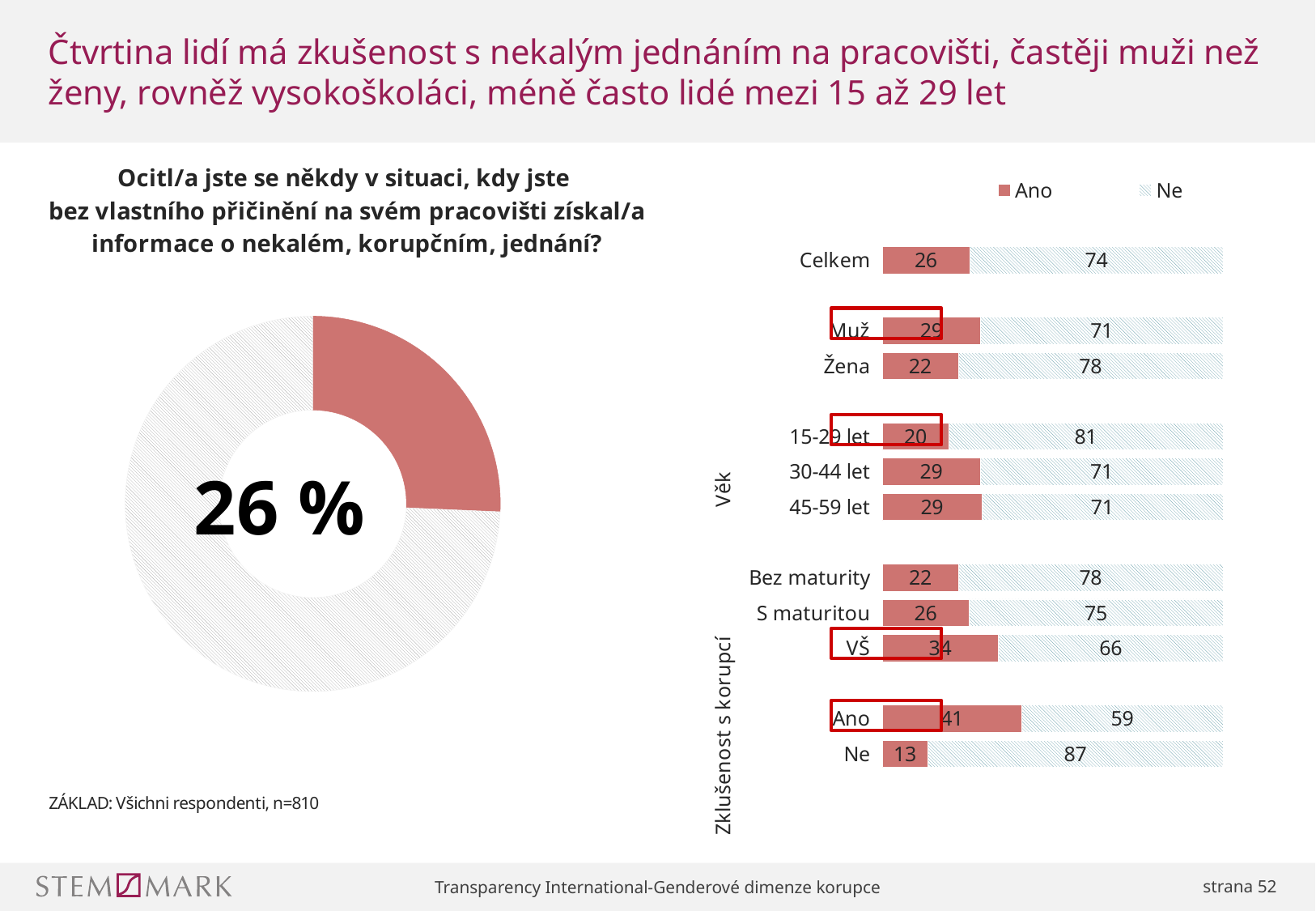
What percentage is shown in the centre of the donut chart on the left? 26 % In the bar chart on the right, what is the total of the stacked bar for Celkem? 100 In the bar chart on the right, which has a larger 'Ano' value, Bez maturity or VŠ? VŠ In the bar chart on the right, which category has the lowest 'Ano' value? Ne What kind of chart is shown on the left side of the slide? Donut chart In the bar chart on the right, what is the 'Ano' value for VŠ? 34 In the bar chart on the right, how many series does the legend list? 2 In the bar chart on the right, which category has the highest 'Ano' value? Ano In the bar chart on the right, how many categories are plotted? 11 In the bar chart on the right, what is the 'Ne' value for 15-29 let? 81 In the bar chart on the right, what is the difference between the 'Ano' values for Muž and Žena? 7 In the bar chart on the right, what is the 'Ano' value for Muž? 29